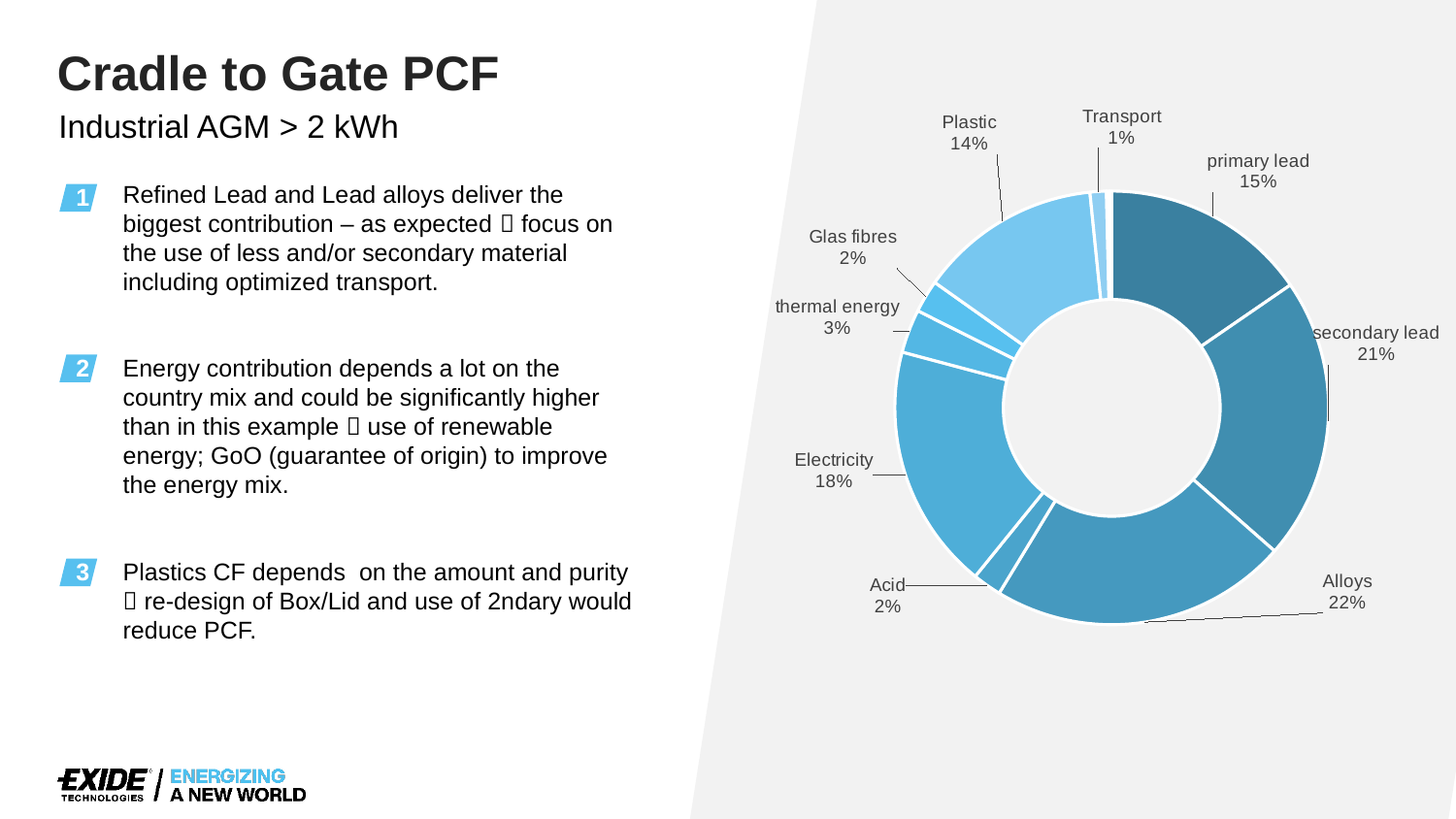
What share does thermal energy have in the chart? 3% Which category has the largest share in the chart? Alloys Which category has the smallest share in the chart? Transport What is the difference between the shares of secondary lead and primary lead? 6% What share does Plastic have in the chart? 14% What share does secondary lead have in the chart? 21% What is the combined share of primary lead and secondary lead? 36% What share does Alloys have in the chart? 22% How many categories are shown in the chart? 9 What kind of chart is shown on the slide? Doughnut chart Which has a larger share, Electricity or Plastic? Electricity What share does Electricity have in the chart? 18%